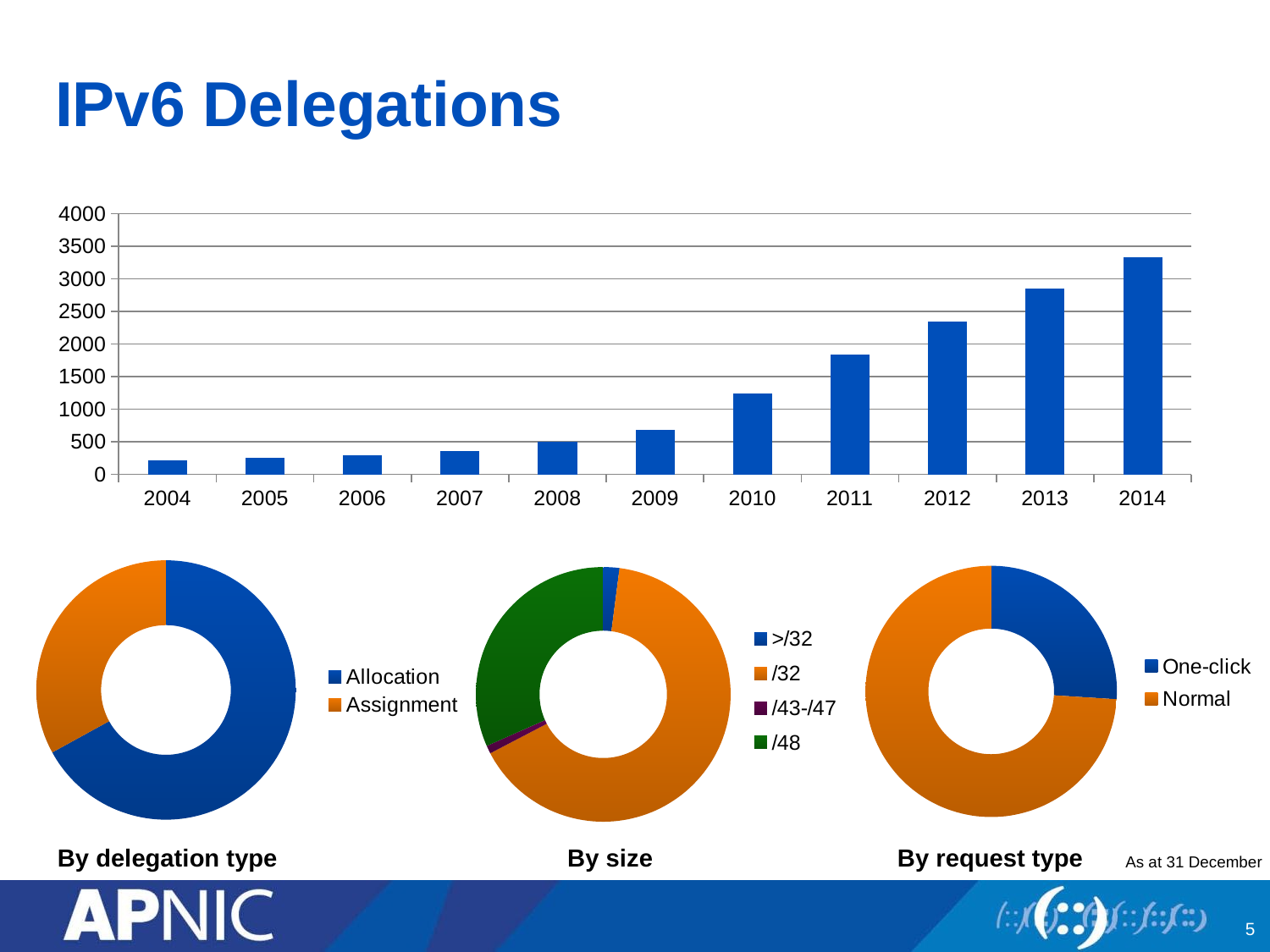
In the top bar chart, do the values rise or fall from 2004 to 2014? rise In the top bar chart, how many years are shown on the x axis? 11 In the top bar chart, which year has the highest value? 2014 In the top bar chart, is the value for 2012 greater or less than 2000? greater In the top bar chart, is the value for 2007 greater or less than 500? less In the top bar chart, is the value for 2014 greater or less than 3000? greater In the 'By size' donut chart, which category has the largest share? /32 In the 'By delegation type' donut chart, which is larger, Allocation or Assignment? Allocation What kind of chart is the top chart on the slide? bar chart In the top bar chart, which is larger, the value for 2010 or the value for 2013? 2013 How many entries does the legend of the 'By size' donut chart list? 4